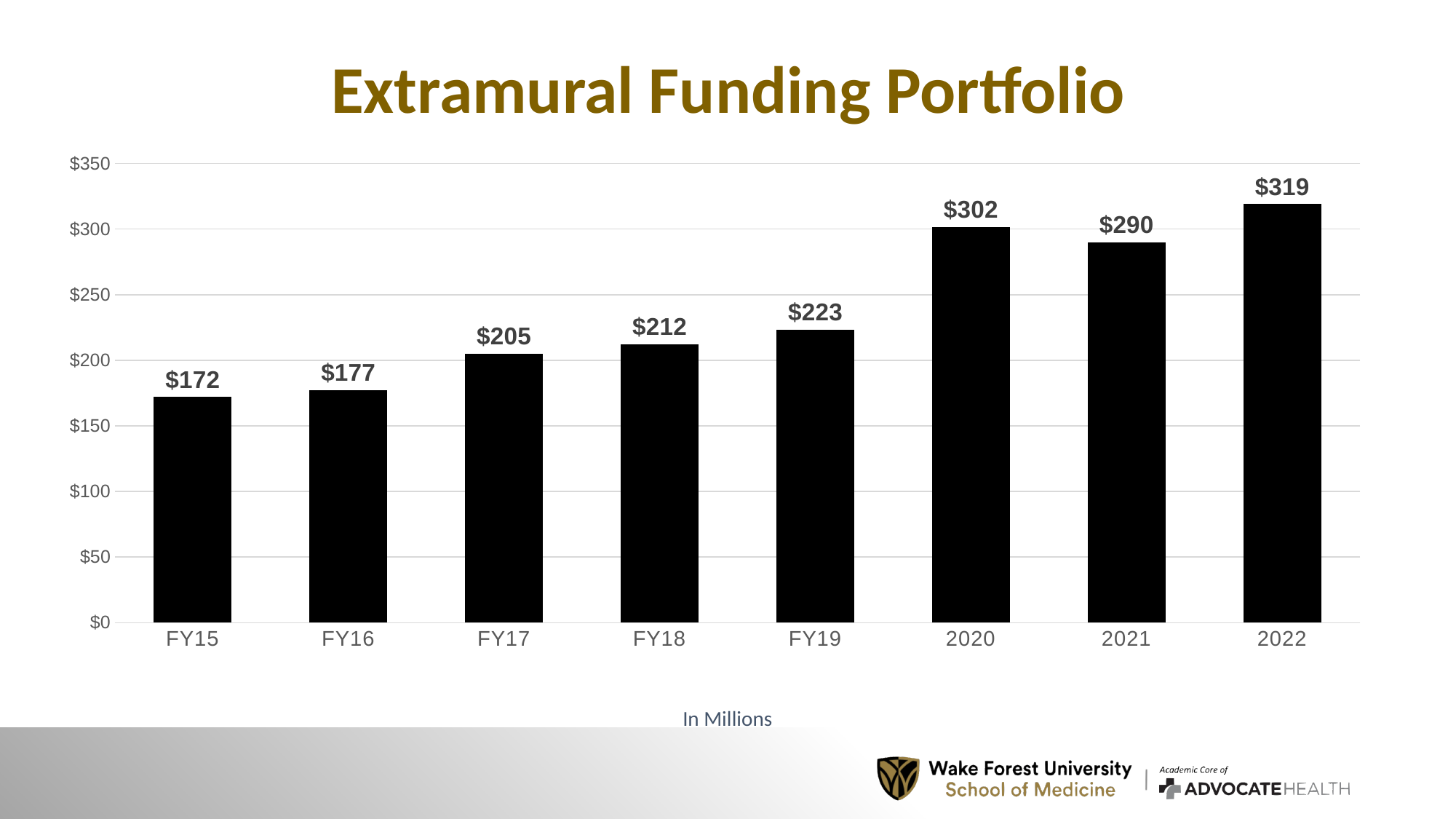
What is the difference between the values for 2022 and FY15? $147 What is the value for 2021? $290 Which year has the lowest value? FY15 What kind of chart is shown on the slide? bar chart Which is larger, the value for 2020 or the value for 2021? 2020 What is the difference between the values for 2020 and 2021? $12 Is the value for FY19 greater or less than $250? less What is the title of the chart? Extramural Funding Portfolio What is the value for FY15? $172 Which year has the highest value? 2022 How many years are shown on the x axis? 8 What is the value for FY18? $212